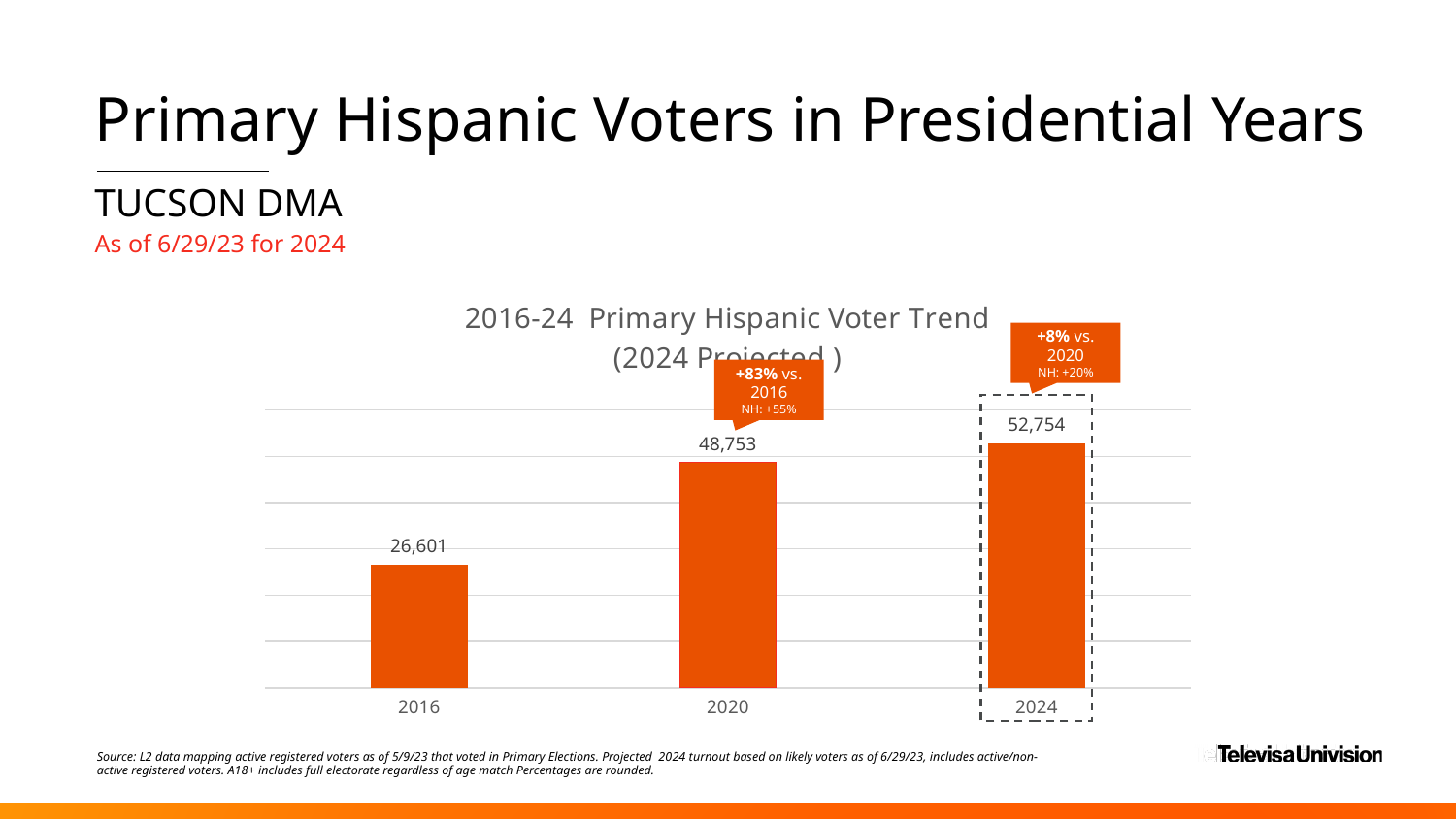
Do the values rise or fall from 2016 to 2024? Rise What is the difference between the 2024 and 2020 values? 4,001 What is the difference between the 2020 and 2016 values? 22,152 What is the value for 2016? 26,601 How many years are shown on the x axis? 3 What is the value for 2020? 48,753 What is the projected value for 2024? 52,754 Which year has the highest value? 2024 Which is larger, the value for 2016 or the value for 2020? 2020 What is the title of the chart? 2016-24 Primary Hispanic Voter Trend (2024 Projected) Which year has the lowest value? 2016 What kind of chart is this? Bar chart